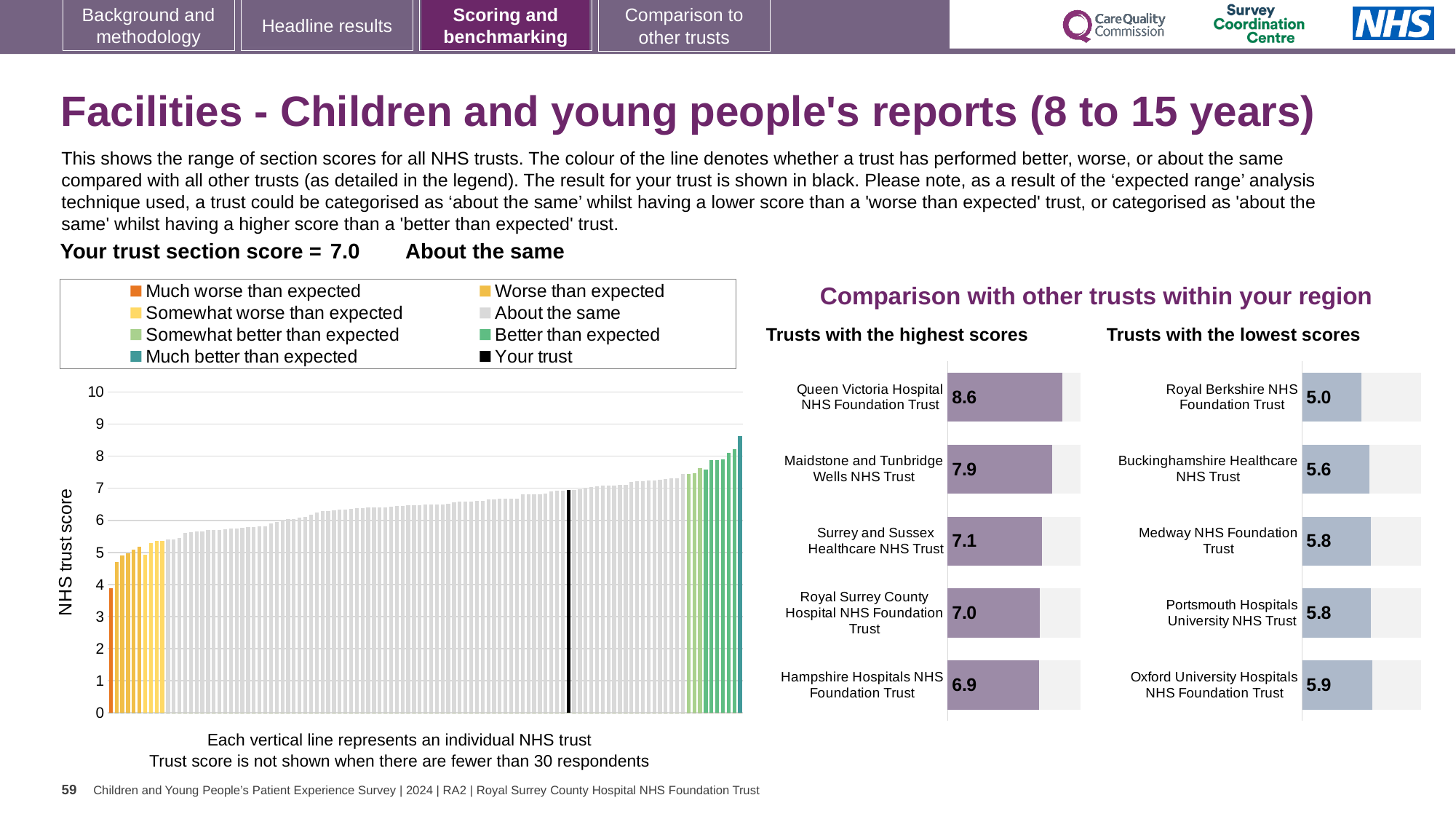
How many trusts are listed in the 'Trusts with the highest scores' chart? 5 In the 'Trusts with the lowest scores' chart, which trust has the lowest score? Royal Berkshire NHS Foundation Trust In the 'Trusts with the highest scores' chart, what is the score for Queen Victoria Hospital NHS Foundation Trust? 8.6 In the NHS trust score chart on the left, do the values rise or fall from left to right? rise How many entries does the legend of the NHS trust score chart on the left list? 8 In the 'Trusts with the highest scores' chart, what is the score for Hampshire Hospitals NHS Foundation Trust? 6.9 In the 'Trusts with the lowest scores' chart, which has the higher score: Buckinghamshire Healthcare NHS Trust or Oxford University Hospitals NHS Foundation Trust? Oxford University Hospitals NHS Foundation Trust In the 'Trusts with the highest scores' chart, which trust has the highest score? Queen Victoria Hospital NHS Foundation Trust In the 'Trusts with the lowest scores' chart, what is the score for Buckinghamshire Healthcare NHS Trust? 5.6 In the 'Trusts with the lowest scores' chart, what is the difference between the scores of Oxford University Hospitals NHS Foundation Trust and Royal Berkshire NHS Foundation Trust? 0.9 In the 'Trusts with the highest scores' chart, what is the difference between the scores of Queen Victoria Hospital NHS Foundation Trust and Maidstone and Tunbridge Wells NHS Trust? 0.7 In the NHS trust score chart on the left, is the value of the tallest bar greater or less than 8? greater